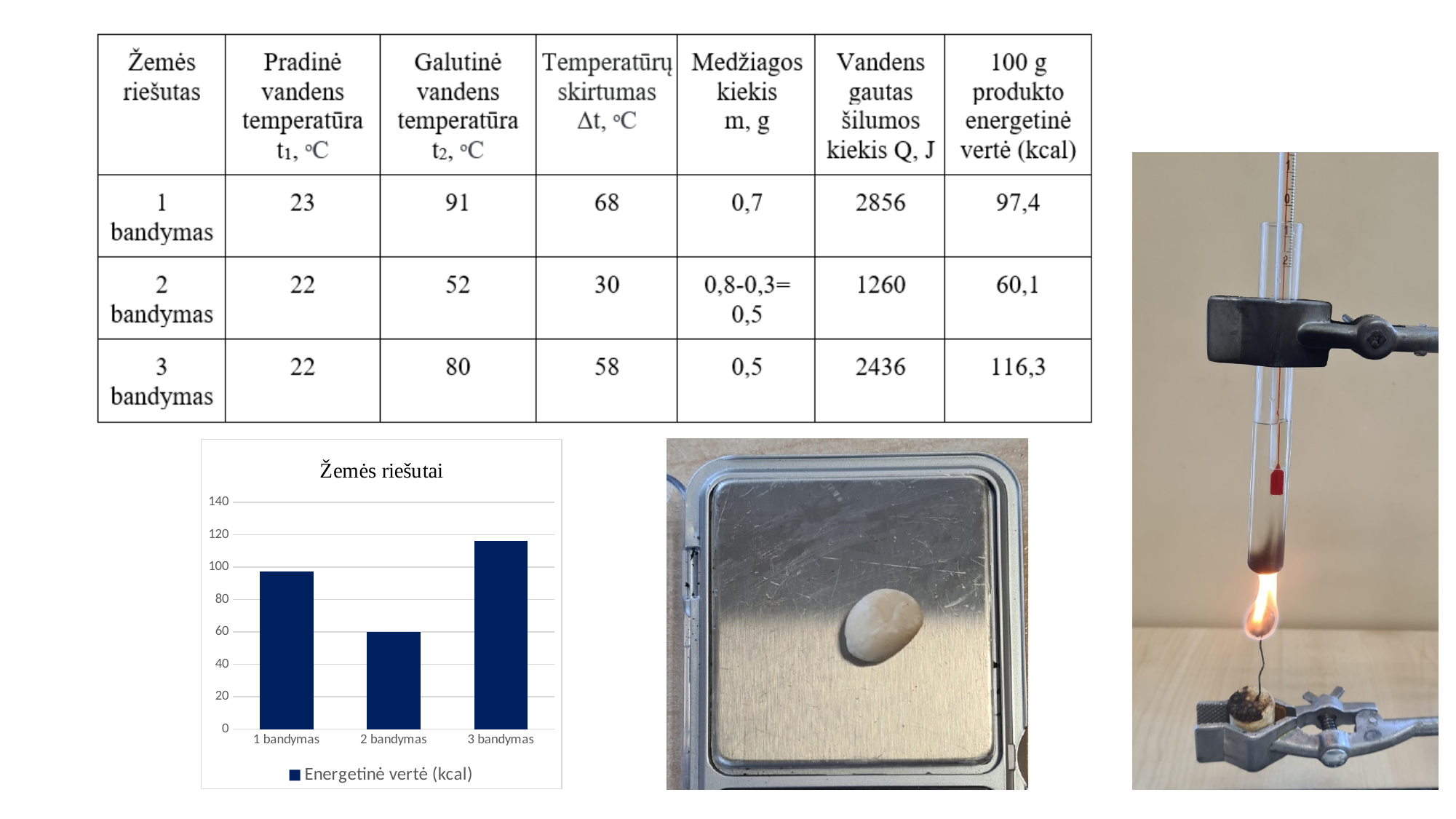
Is the value for 2 bandymas greater or less than 80? less Which category has the lowest bar in the chart? 2 bandymas Which category has the highest bar in the chart? 3 bandymas Which is larger in the chart, the value for 1 bandymas or the value for 2 bandymas? 1 bandymas What is the title of the chart? Žemės riešutai How many series does the chart legend list? 1 Is the value for 1 bandymas greater or less than 80? greater How many categories are shown on the x axis of the chart? 3 Which is larger in the chart, the value for 3 bandymas or the value for 1 bandymas? 3 bandymas What is the legend entry of the chart? Energetinė vertė (kcal) Is the value for 3 bandymas greater or less than 100? greater What kind of chart is shown on the slide? bar chart